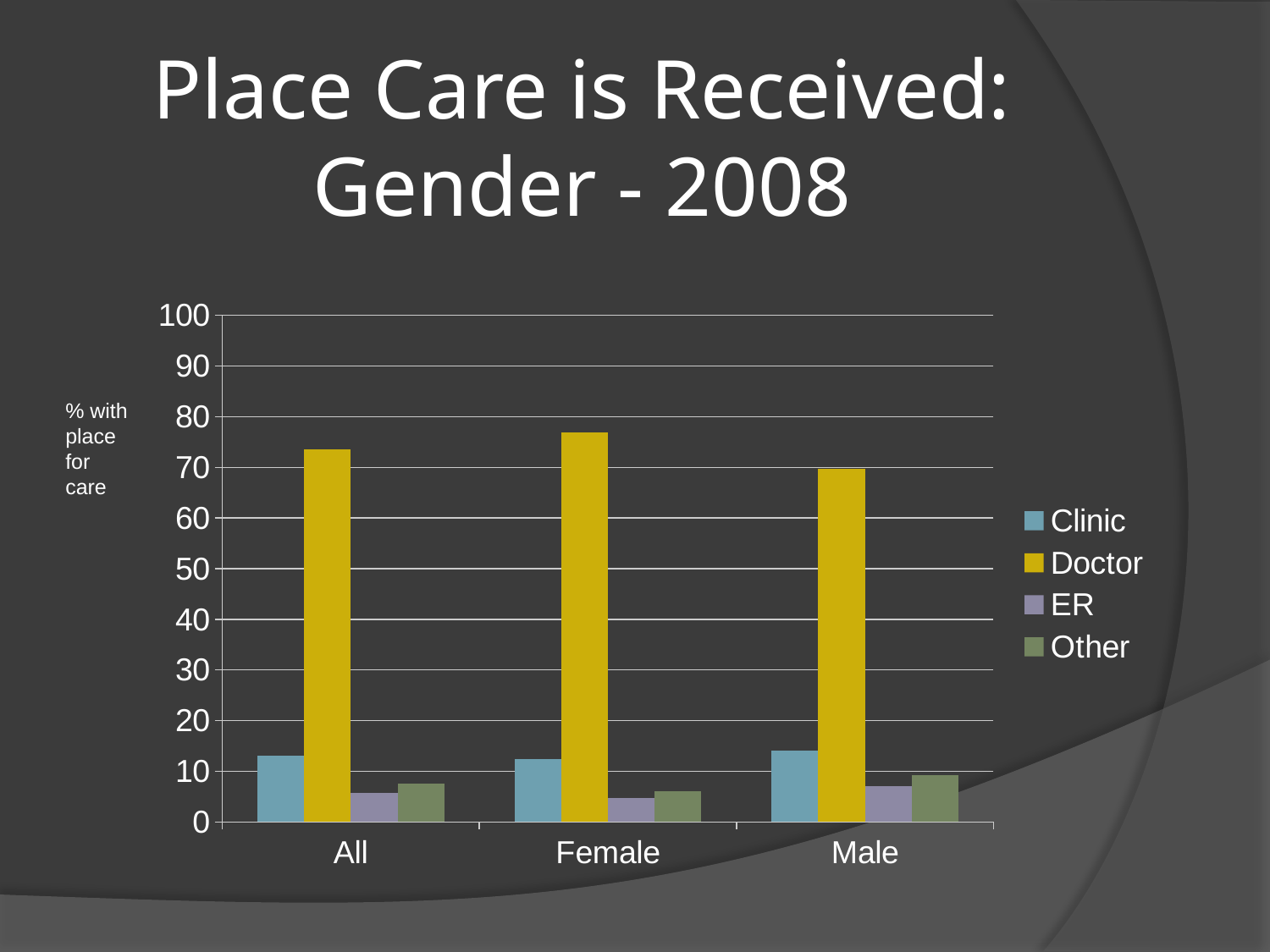
Which is larger for the All category, the Clinic value or the Other value? Clinic Is the Doctor value for Male greater or less than 80? less Which category has the highest Doctor bar? Female Is the Clinic value for All greater or less than 10? greater How many categories are shown on the x axis? 3 How many series does the legend list? 4 What is the title of the slide? Place Care is Received: Gender - 2008 Which is larger, the Doctor value for Female or the Doctor value for Male? Female Is the ER value for Female greater or less than 10? less Which category has the lowest Doctor bar? Male What kind of chart is shown on the slide? bar chart